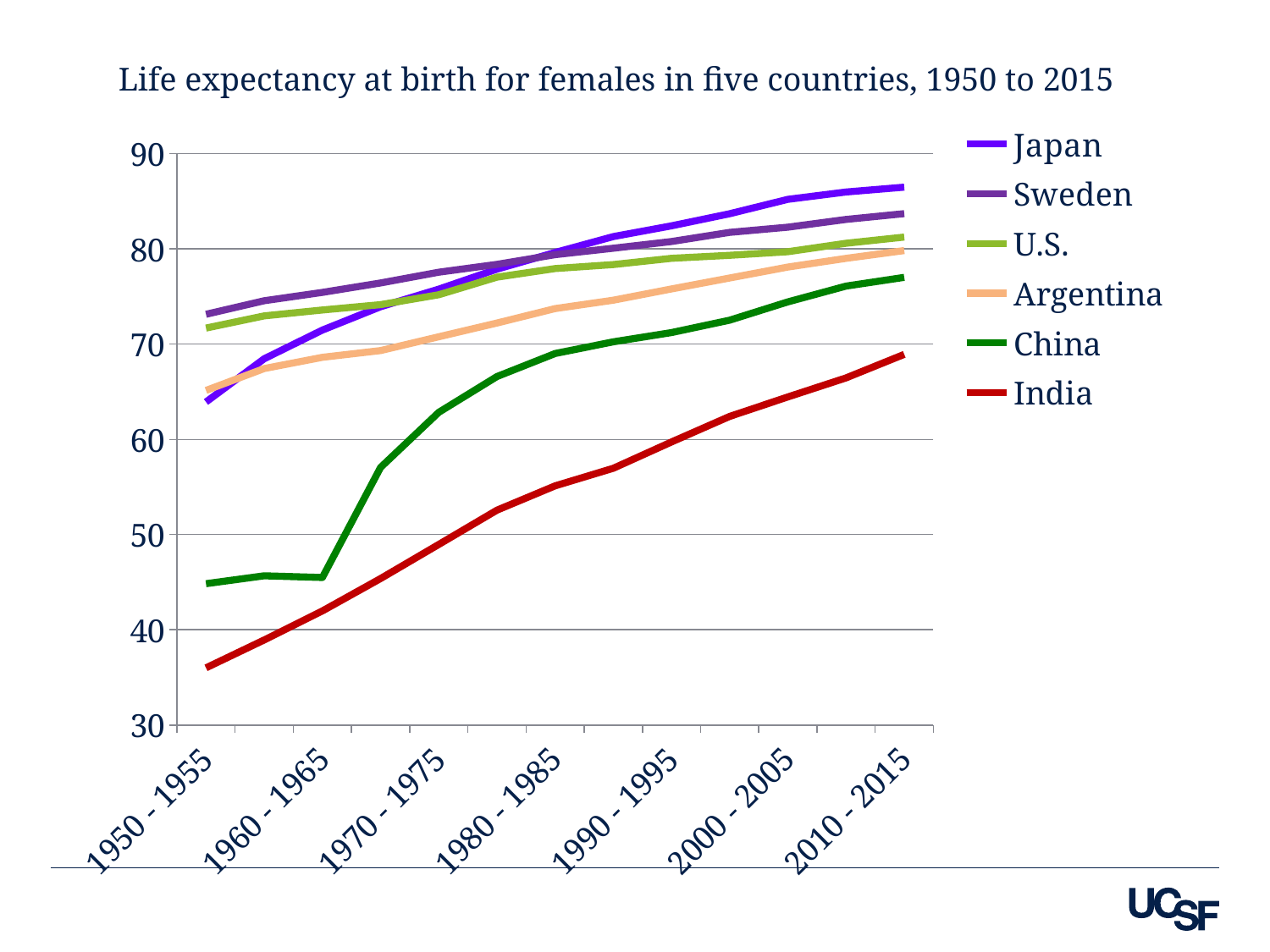
What is the title of the chart? Life expectancy at birth for females in five countries, 1950 to 2015 In 1990 - 1995, which is higher: China or India? China Is the value for India in 1950 - 1955 greater or less than 40? less Which country has the highest female life expectancy in 2010 - 2015? Japan Which country has the lowest female life expectancy in 2010 - 2015? India Which colour is used for the China line? Green Is the value for Japan in 2010 - 2015 greater or less than 80? greater Which country has the highest female life expectancy in 1950 - 1955? Sweden What kind of chart is shown on the slide? Line chart How many series does the legend list? 6 Is the value for China in 1970 - 1975 greater or less than 60? greater Does the line for India rise or fall from 1950 - 1955 to 2010 - 2015? Rises